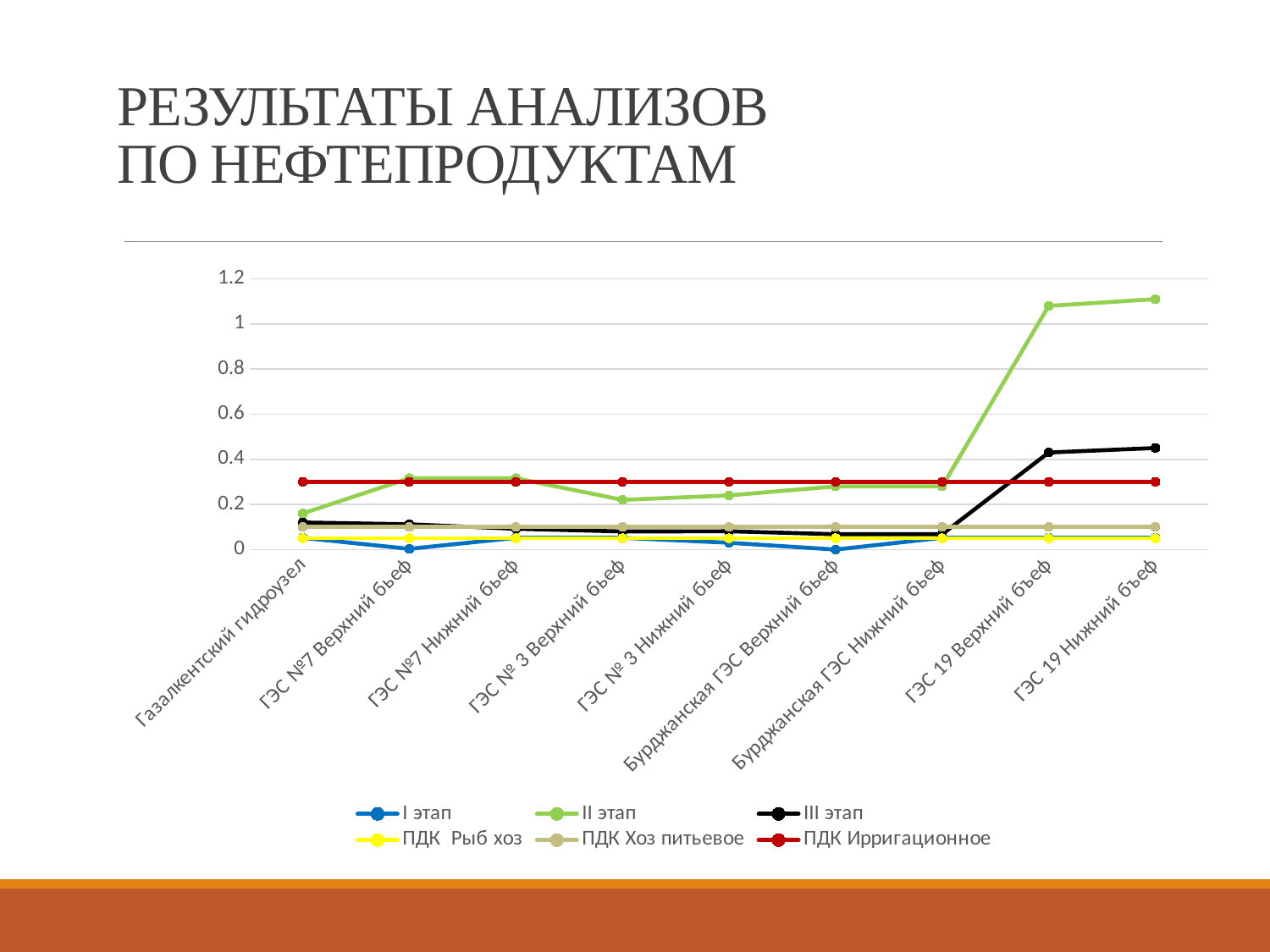
At ГЭС 19 Нижний бьеф, which is larger: II этап or III этап? II этап How many series does the legend list? 6 How many categories are shown along the x axis? 9 For II этап, which is larger: the value at ГЭС 19 Верхний бьеф or at ГЭС № 3 Верхний бьеф? ГЭС 19 Верхний бьеф Does the II этап line rise or fall from Бурджанская ГЭС Нижний бьеф to ГЭС 19 Верхний бьеф? rises What colour is the ПДК Ирригационное line? red Is the value of II этап at ГЭС 19 Нижний бьеф greater or less than 1? greater Is the value of III этап at ГЭС 19 Нижний бьеф greater or less than 0.4? greater Is the value of III этап at Газалкентский гидроузел greater or less than 0.2? less What kind of chart is shown on the slide? line chart